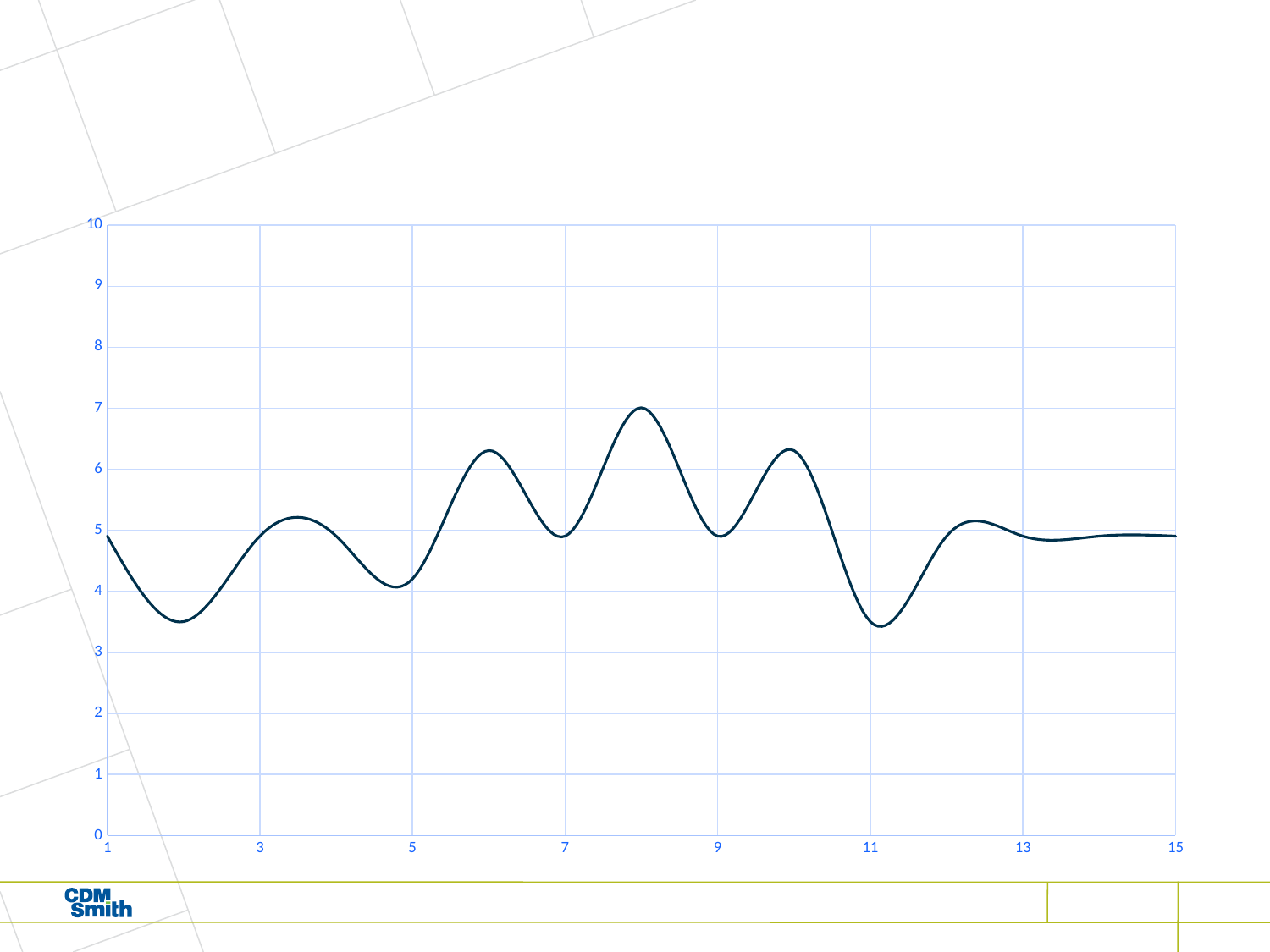
Is the value of the line at x = 6 greater or less than 6? greater Which is larger, the value of the line at x = 8 or at x = 2? x = 8 What is the highest value shown on the y axis? 10 At which x-axis value does the line reach its highest point? 8 Is the value of the line at x = 2 greater or less than 4? less What is the value of the line at x = 8? 7 Is the value of the line at x = 11 greater or less than 4? less What kind of chart is shown on the slide? line chart Does the line rise or fall between x = 1 and x = 2? fall How many lines are plotted on the chart? 1